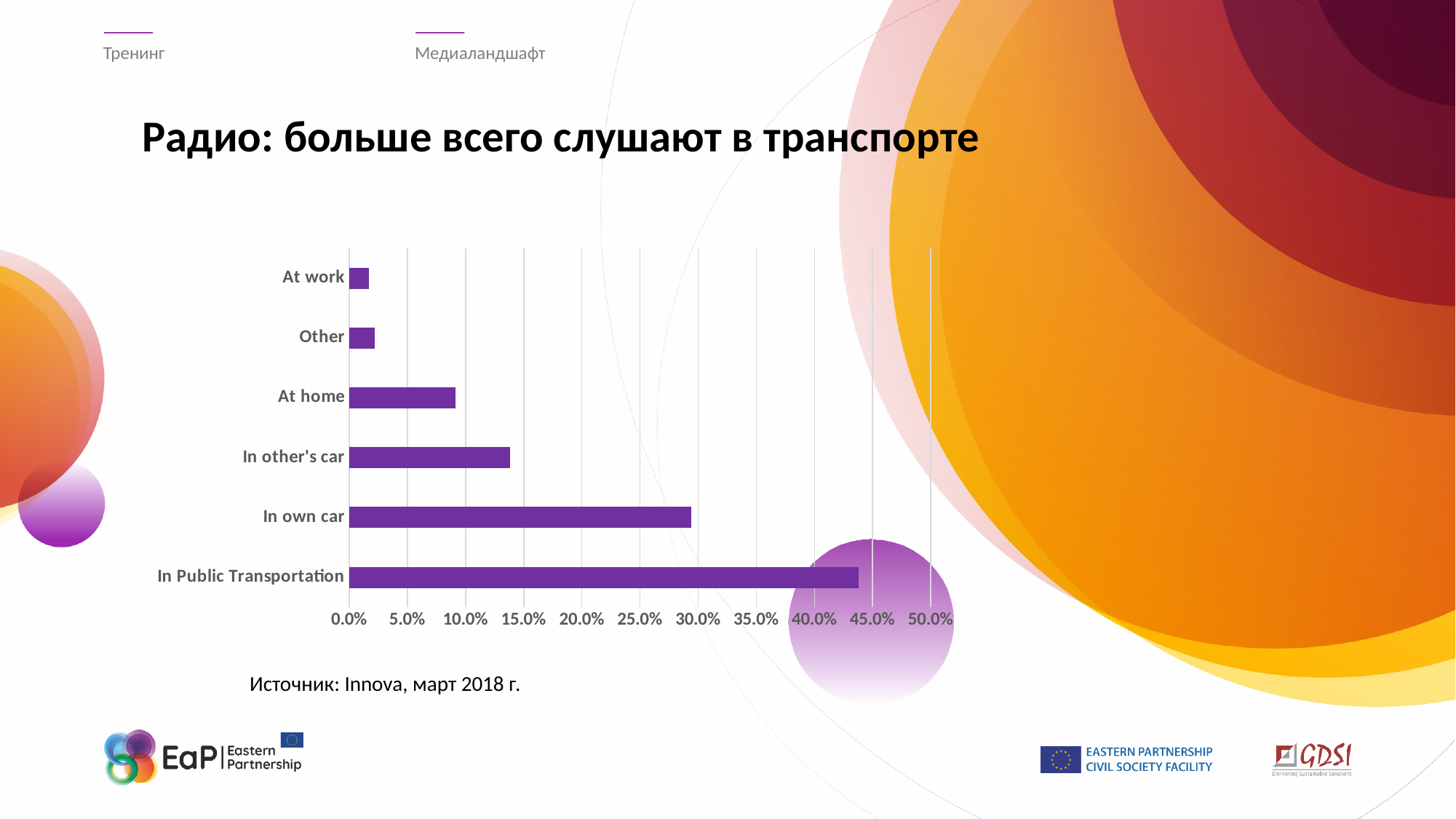
Which category has the highest value in the chart? In Public Transportation Is the value for In Public Transportation greater or less than 40.0%? greater Is the value for In other's car greater or less than 10.0%? greater Which is larger, the value for At home or the value for In other's car? In other's car How many categories are plotted in the chart? 6 Is the value for At work greater or less than 5.0%? less Which is larger, the value for In own car or the value for In other's car? In own car What colour are the bars in the chart? Purple What source is cited below the chart? Innova, март 2018 г. What kind of chart is shown on the slide? Bar chart